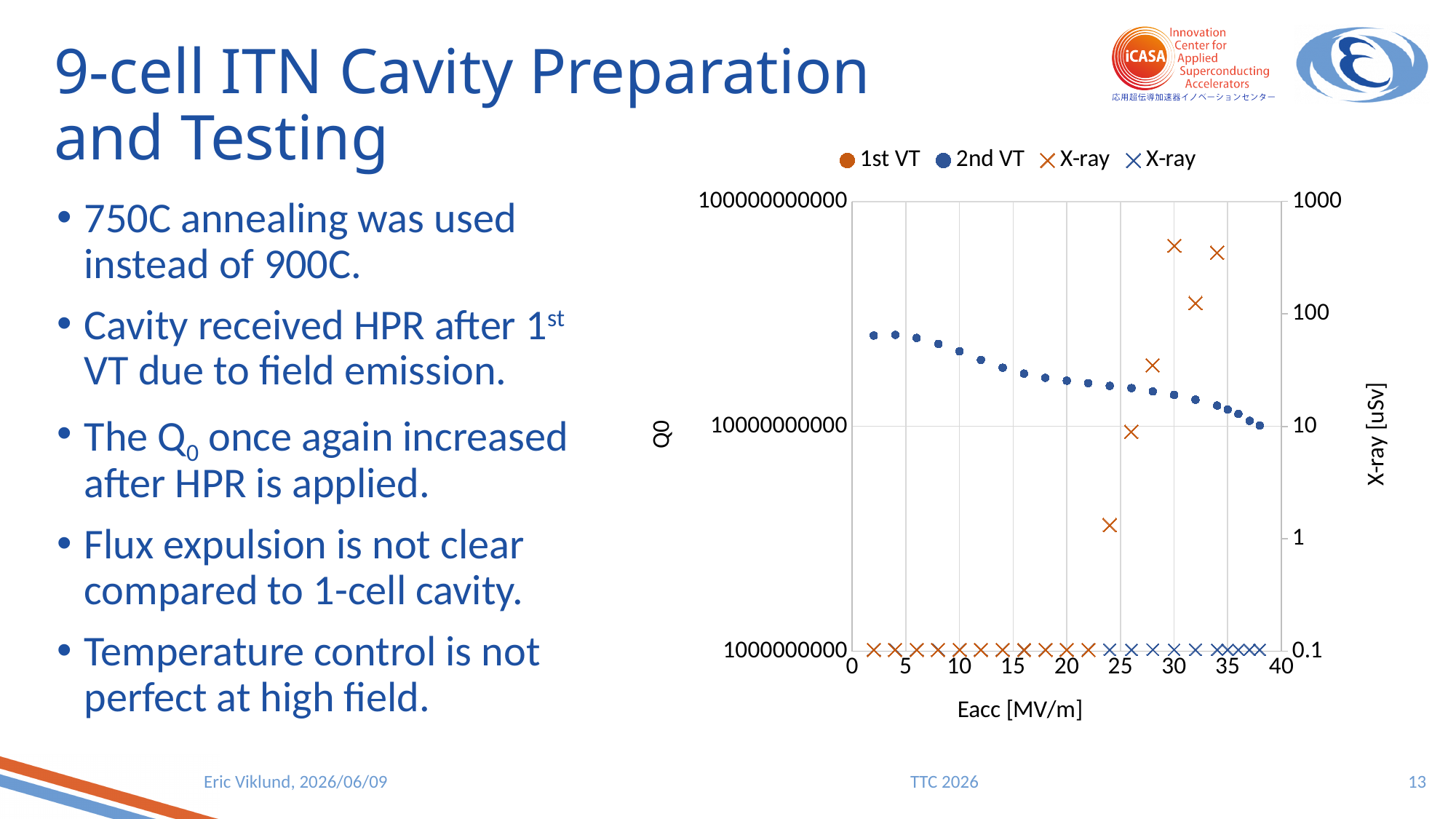
What is the label of the right-hand (secondary) y axis of the chart? X-ray [uSv] Is the blue X-ray value at Eacc of about 36 MV/m greater or less than 1 uSv? less Which is larger, the orange X-ray value at Eacc of about 30 MV/m or at about 32 MV/m? 30 MV/m How many series does the chart legend list? 4 Is the orange X-ray value at Eacc of about 30 MV/m greater or less than 100 uSv? greater What is the label of the x axis of the chart? Eacc [MV/m] Is the orange X-ray value at Eacc of about 28 MV/m greater or less than 10 uSv? greater Does the 2nd VT Q0 rise or fall as Eacc increases? fall What kind of chart is shown on the slide? scatter chart